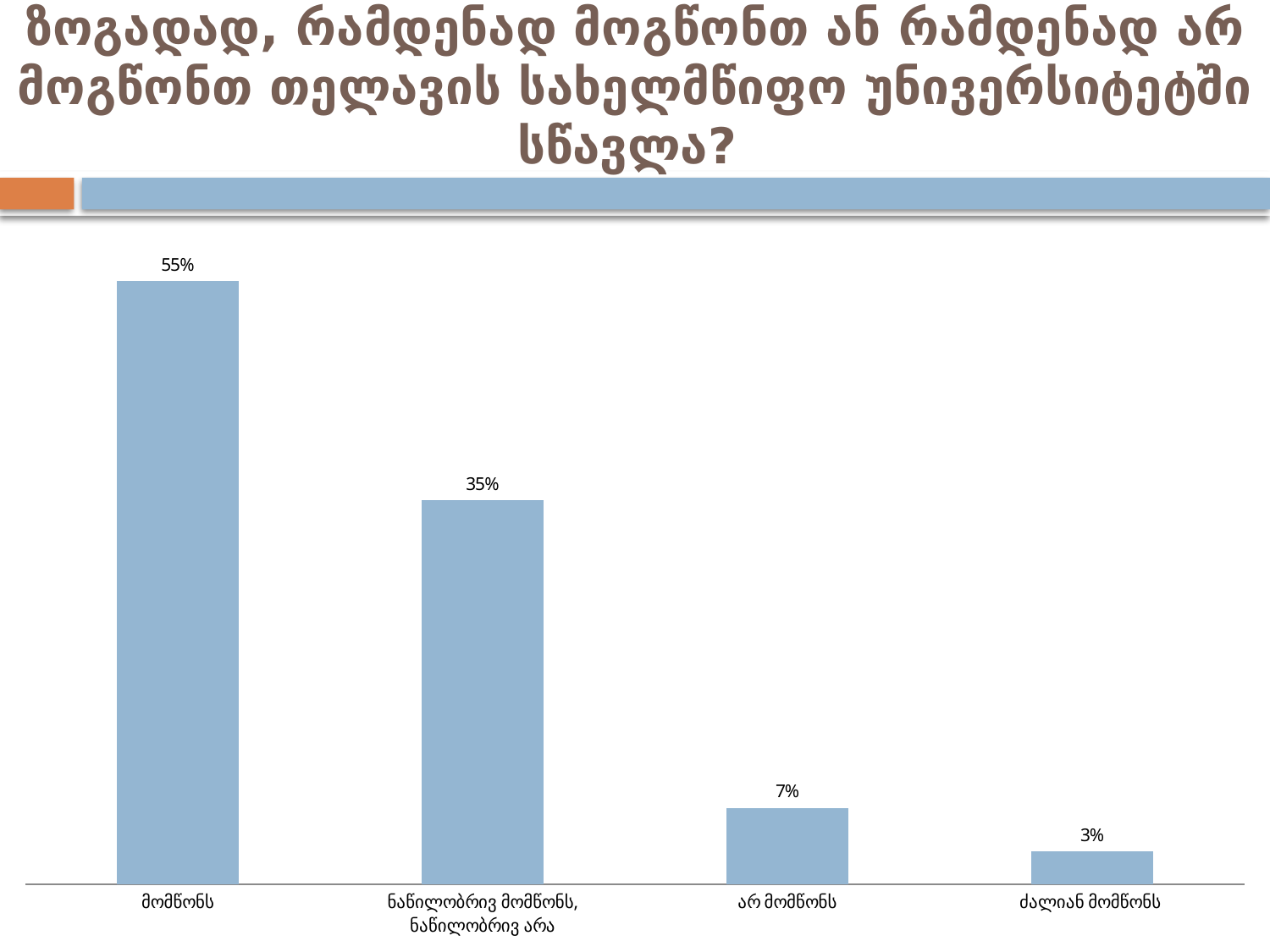
What is the difference between the values for "მომწონს" and "ნაწილობრივ მომწონს, ნაწილობრივ არა"? 20% Which category has the lowest value? ძალიან მომწონს What value is shown for the category "მომწონს"? 55% Do the values rise or fall from left to right across the categories? Fall What kind of chart is shown on the slide? Bar chart What is the difference between the values for "არ მომწონს" and "ძალიან მომწონს"? 4% What value is shown for the category "ნაწილობრივ მომწონს, ნაწილობრივ არა"? 35% Which category has the highest value? მომწონს Which is larger, the value for "არ მომწონს" or the value for "ძალიან მომწონს"? არ მომწონს What value is shown for the category "არ მომწონს"? 7% What value is shown for the category "ძალიან მომწონს"? 3% How many categories are shown on the chart? 4